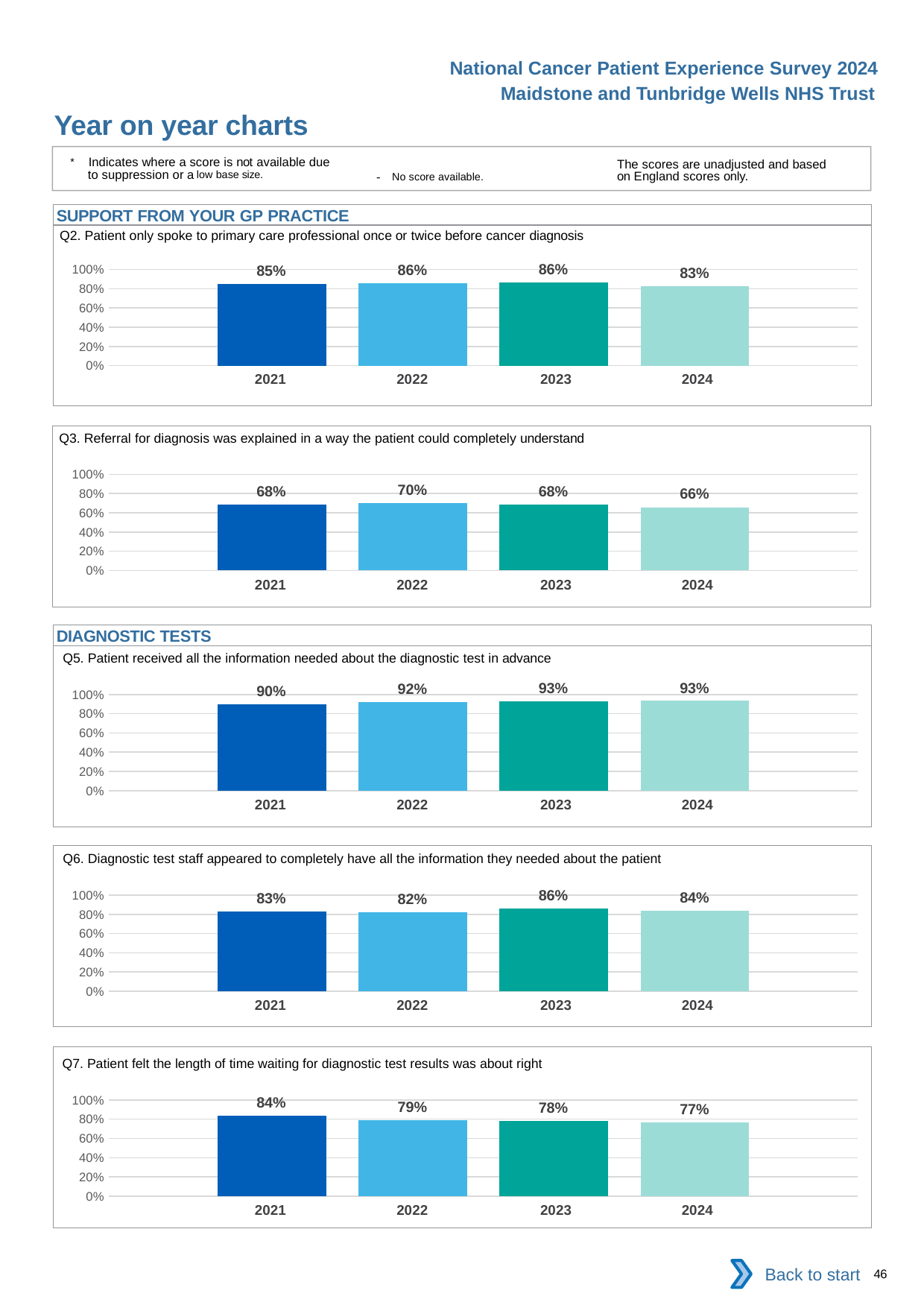
In the Q3 chart (referral for diagnosis was explained in a way the patient could completely understand), which year has the highest value? 2022 In the Q3 chart (referral for diagnosis was explained in a way the patient could completely understand), what is the value for 2024? 66% How many years are shown on the x axis of the Q2 chart? 4 In the Q6 chart (diagnostic test staff appeared to completely have all the information they needed about the patient), what is the value for 2023? 86% In the Q5 chart (patient received all the information needed about the diagnostic test in advance), what is the difference between the 2024 and 2021 values? 3 percentage points In the Q7 chart (patient felt the length of time waiting for diagnostic test results was about right), do the values rise or fall from 2021 to 2024? fall In the Q5 chart (patient received all the information needed about the diagnostic test in advance), which year has the lowest value? 2021 In the Q2 chart (patient only spoke to primary care professional once or twice before cancer diagnosis), what is the value for 2024? 83% In the Q7 chart (patient felt the length of time waiting for diagnostic test results was about right), what is the difference between the 2021 and 2024 values? 7 percentage points In the Q6 chart (diagnostic test staff appeared to completely have all the information they needed about the patient), which is larger, the 2021 value or the 2022 value? 2021 What type of chart is used for Q5 (patient received all the information needed about the diagnostic test in advance)? bar chart Which section heading appears above the Q5 chart? DIAGNOSTIC TESTS